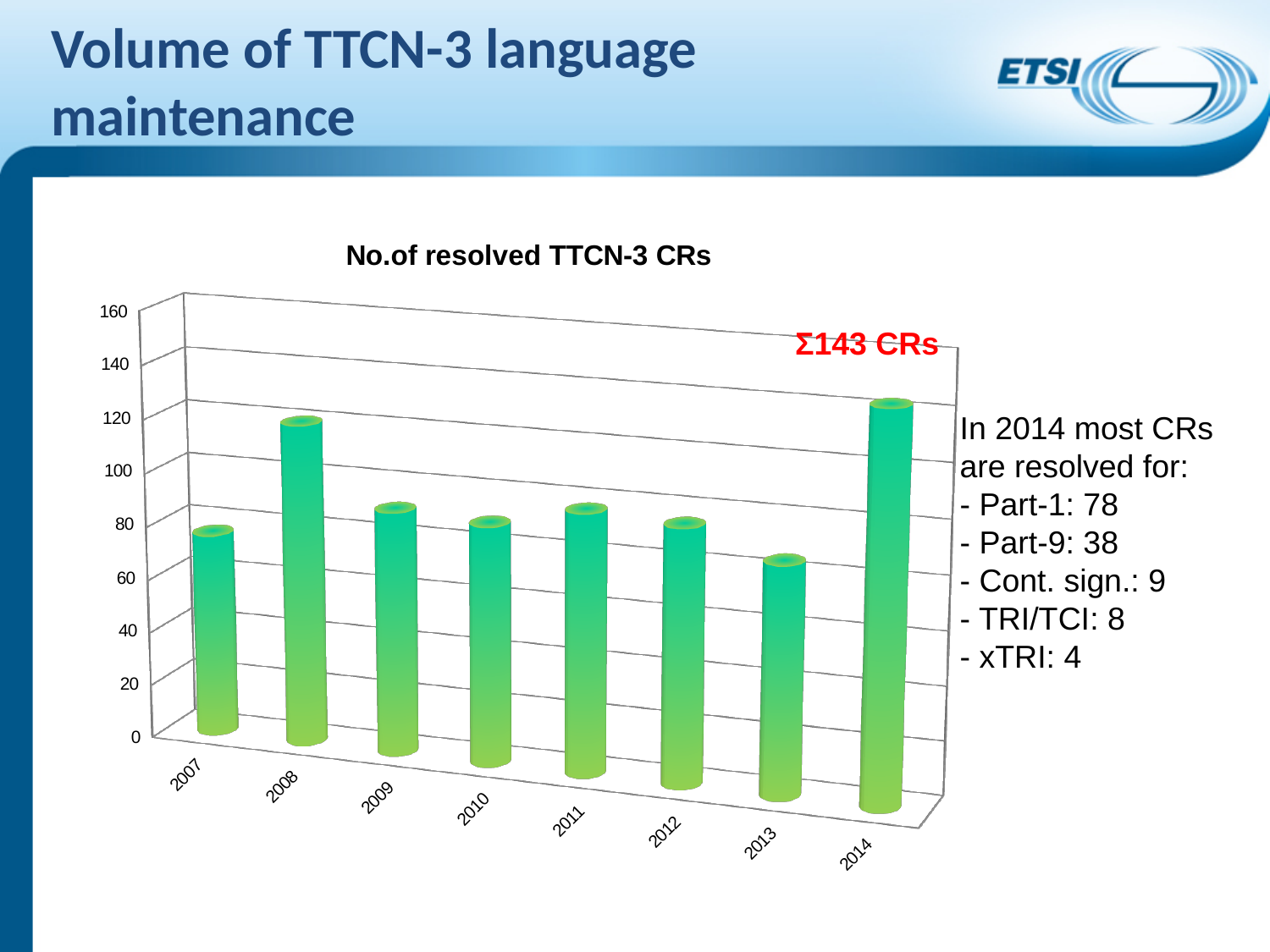
Which year has more resolved CRs, 2007 or 2008? 2008 What kind of chart is shown on the slide? bar chart Which year has the highest number of resolved TTCN-3 CRs? 2014 How many years are shown on the x axis of the chart? 8 Which year has the lowest number of resolved TTCN-3 CRs? 2007 Is the value for 2008 greater or less than 100? greater What is the title of the chart? No.of resolved TTCN-3 CRs Do the values rise or fall from 2013 to 2014? rise Is the value for 2014 greater or less than 120? greater What annotation in red text is shown near the 2014 bar? Σ143 CRs Which year has more resolved CRs, 2008 or 2014? 2014